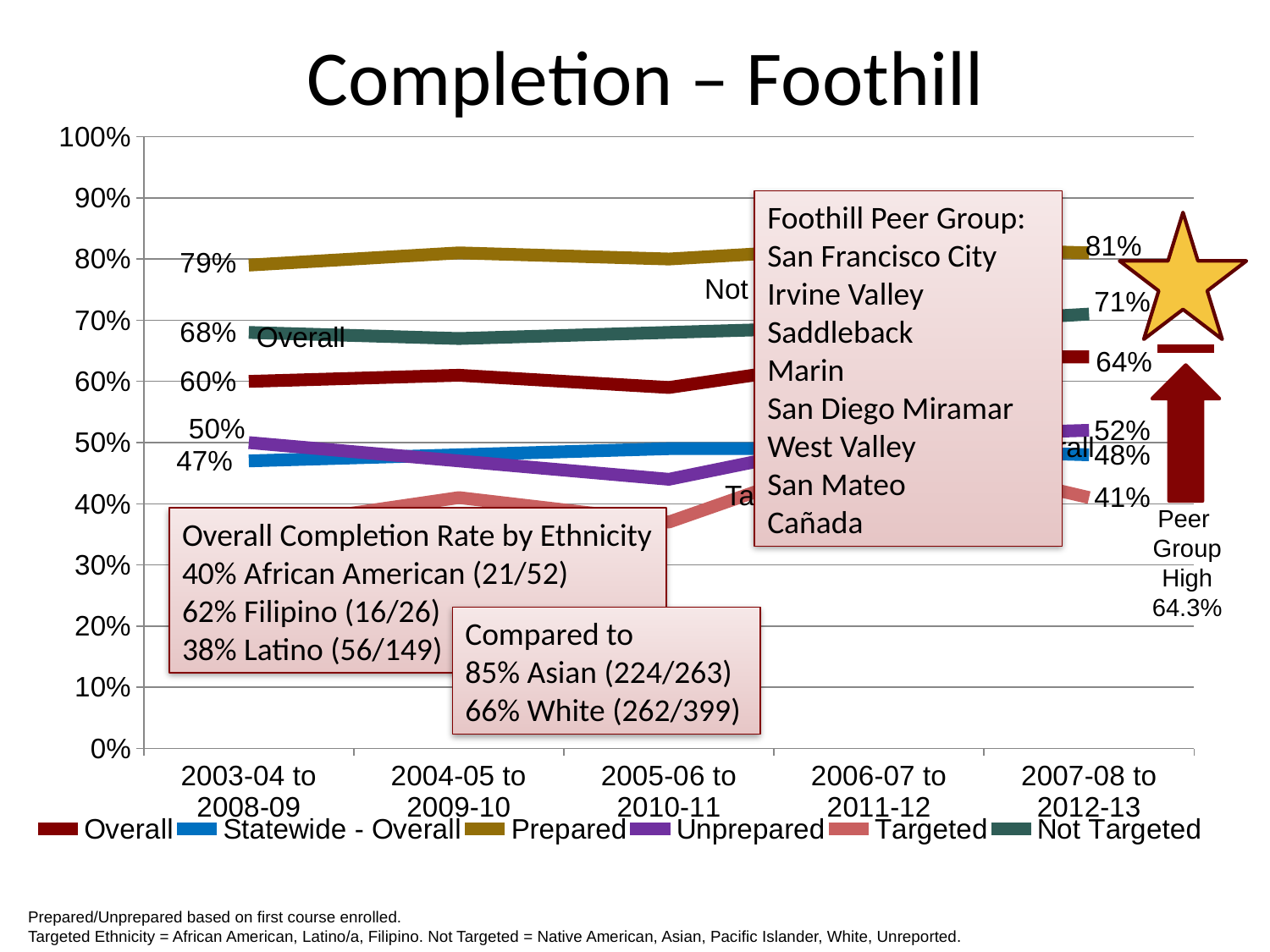
How many series does the legend list? 6 Which series has the highest value in 2007-08 to 2012-13? Prepared What is the Prepared completion rate for 2003-04 to 2008-09? 79% Is the Not Targeted value for 2005-06 to 2010-11 greater or less than 60%? greater In 2007-08 to 2012-13, which is larger: Not Targeted or Unprepared? Not Targeted What is the Overall completion rate for 2007-08 to 2012-13? 64% What is the difference between the Prepared and Targeted values in 2007-08 to 2012-13? 40 percentage points What is the Not Targeted completion rate for 2003-04 to 2008-09? 68% What kind of chart is shown on the slide? line chart Which series has the lowest value in 2007-08 to 2012-13? Targeted How many time periods are shown on the x axis? 5 What is the Prepared completion rate for 2007-08 to 2012-13? 81%